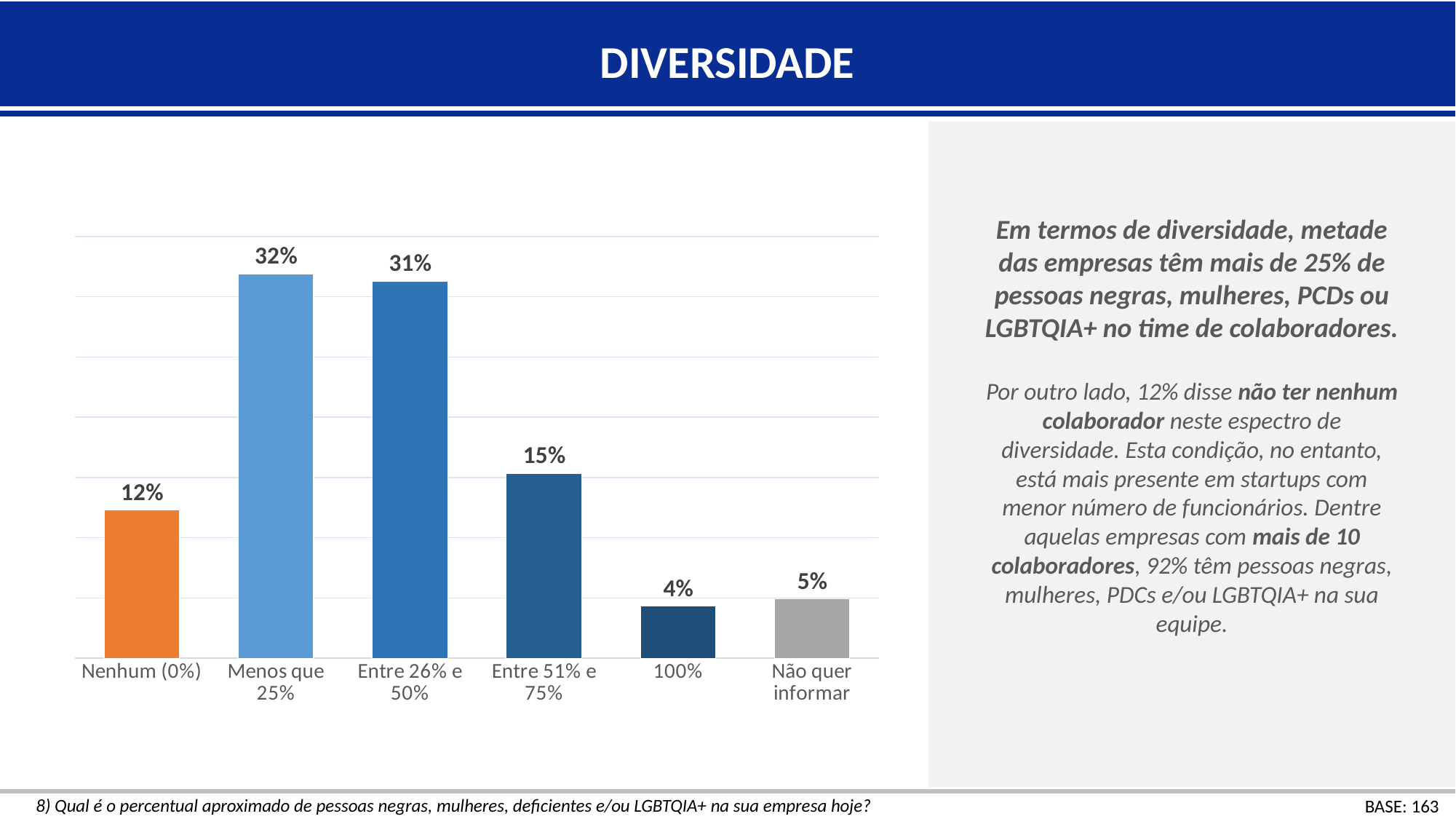
What is the value for the '100%' category? 4% How many categories are shown on the chart? 6 What is the difference between the values for 'Menos que 25%' and 'Entre 26% e 50%'? 1% What is the value for the 'Nenhum (0%)' category? 12% What is the difference between the values for 'Entre 51% e 75%' and 'Nenhum (0%)'? 3% What is the value for the 'Entre 51% e 75%' category? 15% Which is larger, the value for 'Nenhum (0%)' or the value for 'Não quer informar'? Nenhum (0%) Which category has the highest value? Menos que 25% What colour is the bar for 'Nenhum (0%)'? Orange What kind of chart is shown on the slide? Bar chart Which category has the lowest value? 100% What is the value for the 'Não quer informar' category? 5%